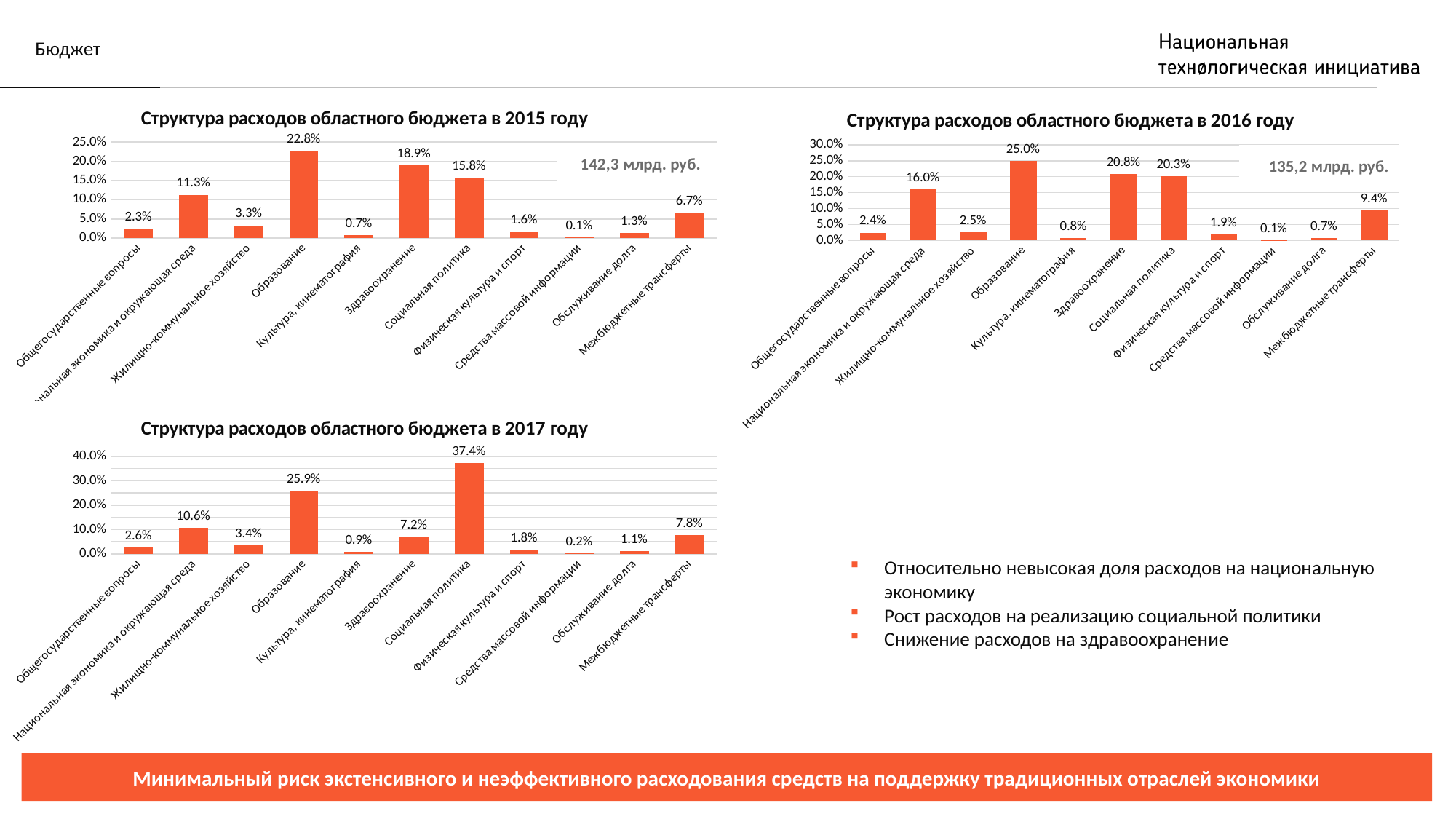
How many categories are shown in the chart 'Структура расходов областного бюджета в 2016 году'? 11 In the chart 'Структура расходов областного бюджета в 2017 году', which is larger: Здравоохранение or Межбюджетные трансферты? Межбюджетные трансферты In the chart 'Структура расходов областного бюджета в 2017 году', is the value for Социальная политика greater or less than 30.0%? greater In the chart 'Структура расходов областного бюджета в 2016 году', what is the value for Здравоохранение? 20.8% In the chart 'Структура расходов областного бюджета в 2016 году', which category has the highest value? Образование In the chart 'Структура расходов областного бюджета в 2016 году', what is the difference between Образование and Социальная политика? 4.7% In the chart 'Структура расходов областного бюджета в 2015 году', which category has the lowest value? Средства массовой информации In the chart 'Структура расходов областного бюджета в 2017 году', what is the value for Национальная экономика и окружающая среда? 10.6% What total budget amount is shown on the chart 'Структура расходов областного бюджета в 2015 году'? 142,3 млрд. руб. What kind of chart is 'Структура расходов областного бюджета в 2015 году'? Bar chart In the chart 'Структура расходов областного бюджета в 2017 году', which category has the highest value? Социальная политика In the chart 'Структура расходов областного бюджета в 2015 году', what is the value for Образование? 22.8%